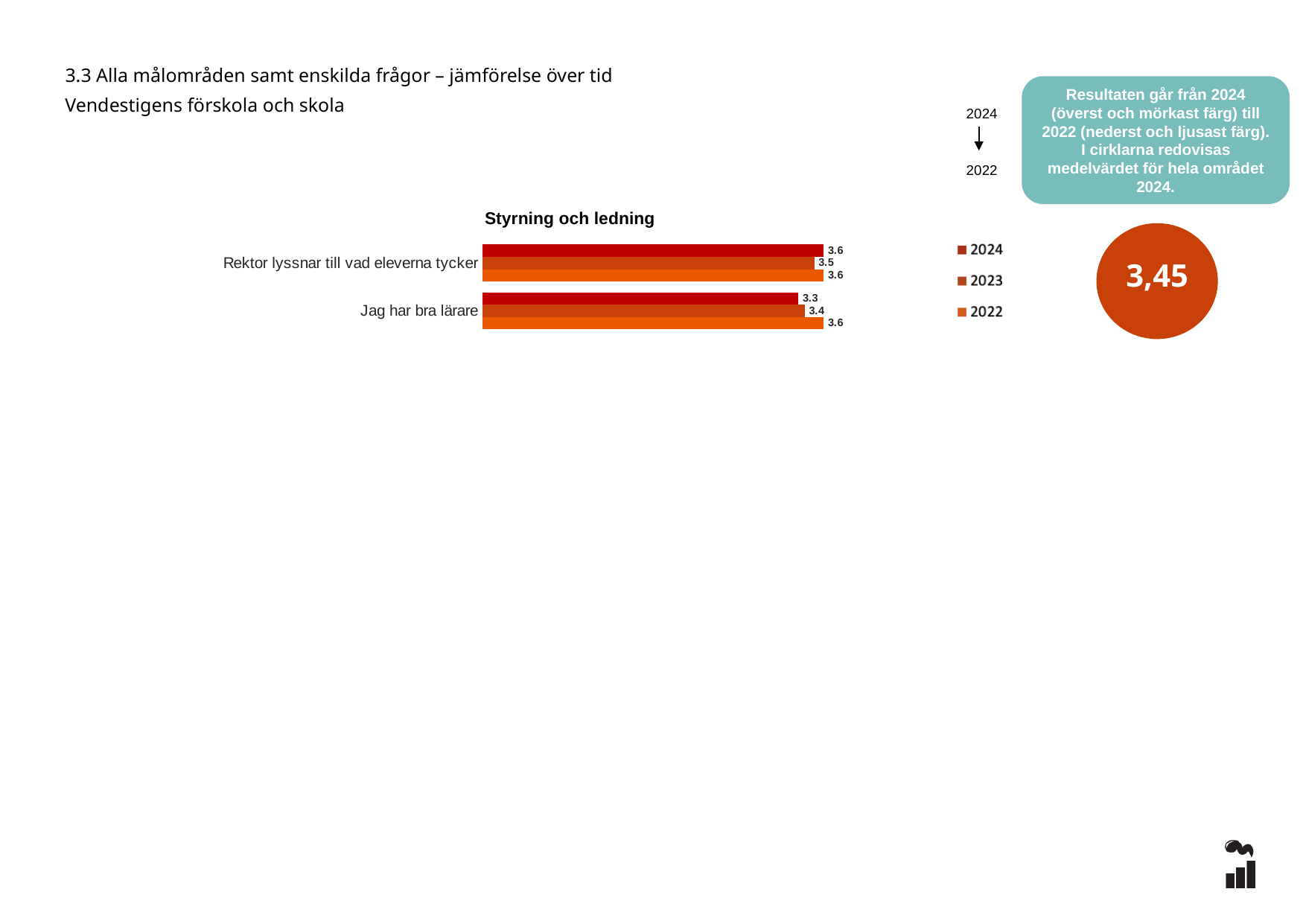
What kind of chart is shown? Bar chart How many series does the legend list? 3 What is the difference between the 2022 and 2024 values for "Jag har bra lärare"? 0.3 How many categories are shown in the chart? 2 What is the 2023 value for "Jag har bra lärare"? 3.4 Which is larger for "Jag har bra lärare": the 2024 value or the 2022 value? 2022 Which category has the lowest 2024 value? Jag har bra lärare What is the 2024 value for "Jag har bra lärare"? 3.3 What is the 2023 value for "Rektor lyssnar till vad eleverna tycker"? 3.5 What is the 2022 value for "Jag har bra lärare"? 3.6 What is the 2024 value for "Rektor lyssnar till vad eleverna tycker"? 3.6 What is the title of the chart? Styrning och ledning